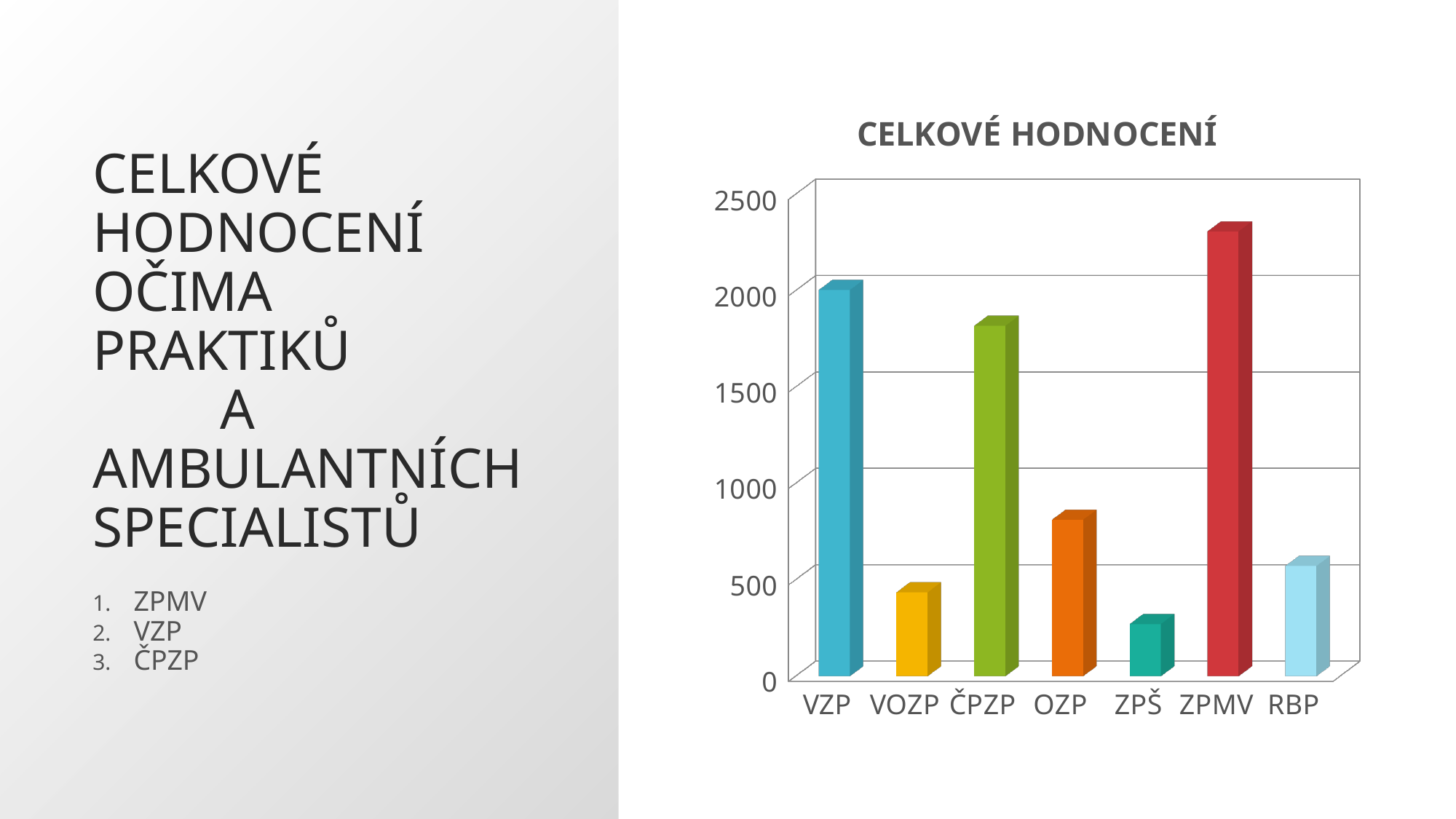
How many categories are shown on the x axis of the chart? 7 Which is larger, the value for OZP or the value for RBP? OZP Is the value for OZP greater or less than 1000? less Which category has the lowest value in the chart? ZPŠ Is the value for VOZP greater or less than 500? less Is the value for ZPMV greater or less than 2000? greater What is the title of the chart? CELKOVÉ HODNOCENÍ What type of chart is shown on the slide? bar chart Which category has the highest value in the chart? ZPMV Which is larger, the value for VZP or the value for ČPZP? VZP